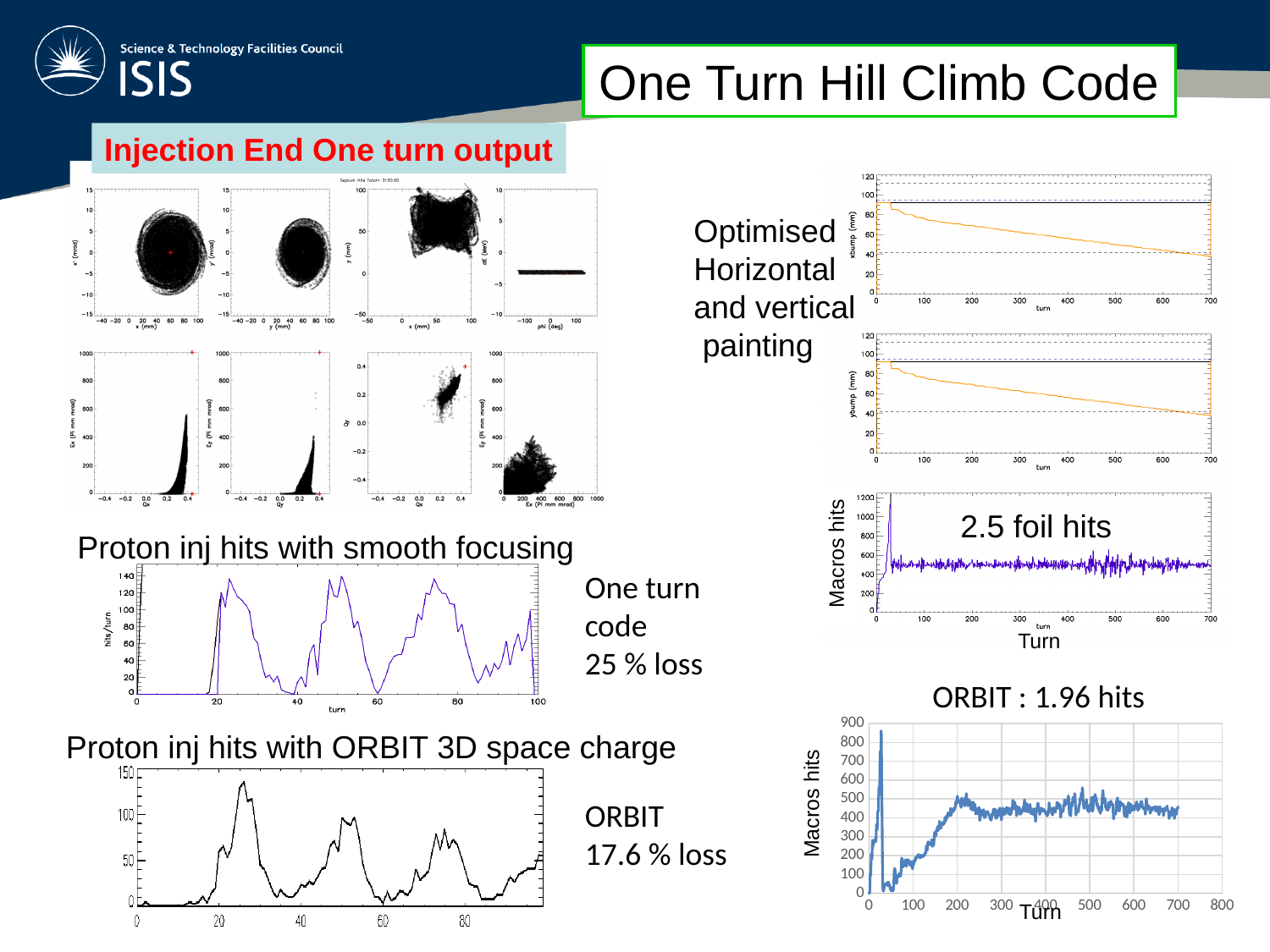
In the 'Proton inj hits with smooth focusing' chart, is the highest peak greater or less than 100 hits/turn? greater What loss percentage is stated next to the 'Proton inj hits with ORBIT 3D space charge' chart? 17.6 % loss In the 'Proton inj hits with smooth focusing' chart, is the value at turn 10 greater or less than 20? less In the xbump (mm) versus turn chart at the top right, do the values rise or fall as turn increases? fall In the 'ORBIT : 1.96 hits' chart at the bottom right, is the value at turn 700 greater or less than 600? less What kind of chart is the 'Proton inj hits with smooth focusing' chart? line chart In the 'ORBIT : 1.96 hits' chart, what is the highest tick shown on the y axis? 900 In the ybump (mm) versus turn chart, do the values rise or fall as turn increases? fall